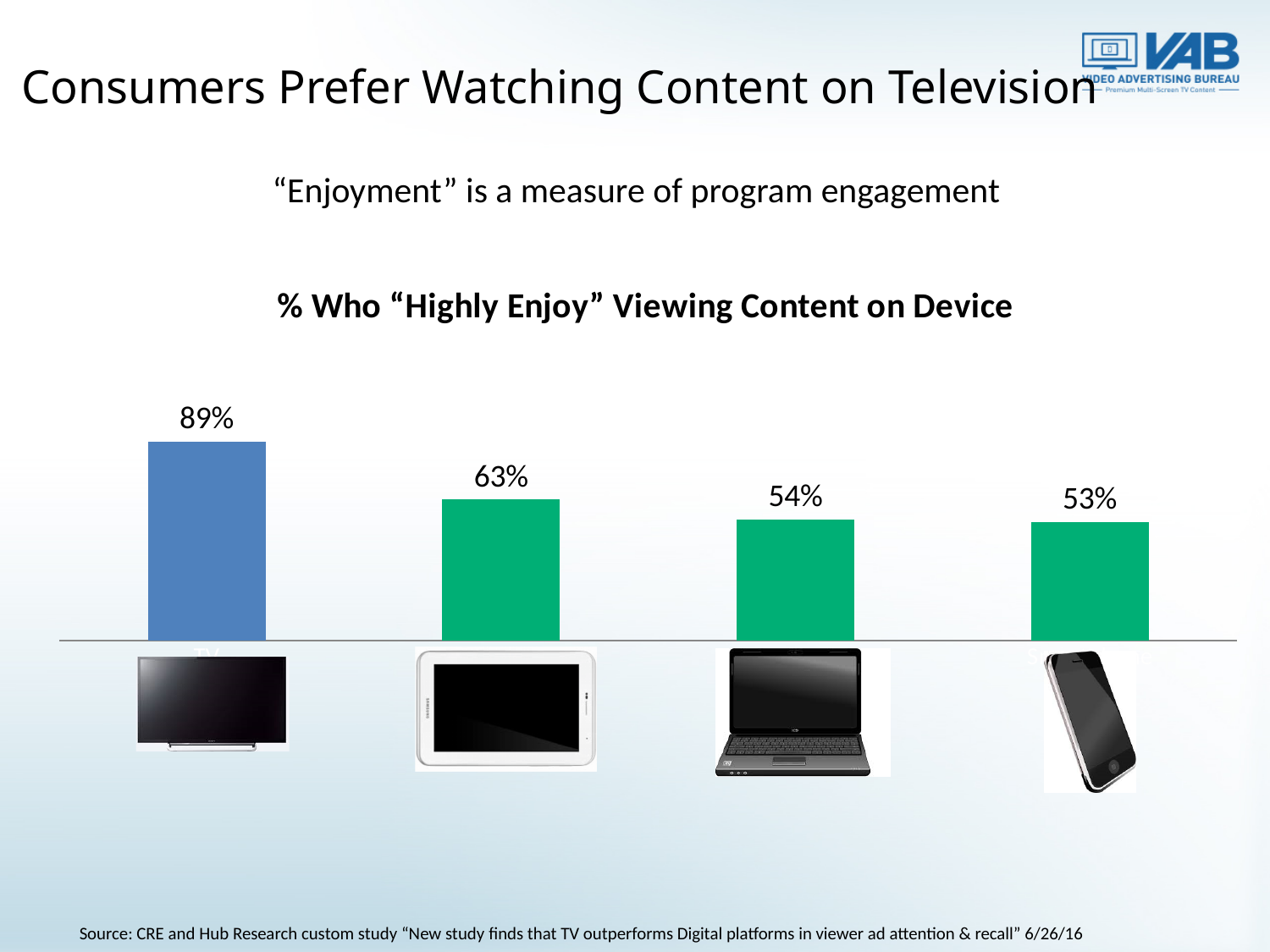
What value is shown for the second bar (above the tablet image)? 63% What is the difference between the first bar (89%) and the fourth bar (53%)? 36 percentage points Which is larger, the value for the second bar (tablet) or the third bar (laptop)? The second bar (tablet), 63% Which bar has the highest value? The first bar (television), 89% What is the title of the chart? % Who "Highly Enjoy" Viewing Content on Device What value is shown for the fourth bar (above the smartphone image)? 53% Which bar has the lowest value? The fourth bar (smartphone), 53% What value is shown for the first bar (above the television image)? 89% What value is shown for the third bar (above the laptop image)? 54% How many bars are plotted in the chart? 4 What is the difference between the first bar (89%) and the second bar (63%)? 26 percentage points What kind of chart is shown on the slide? Bar chart